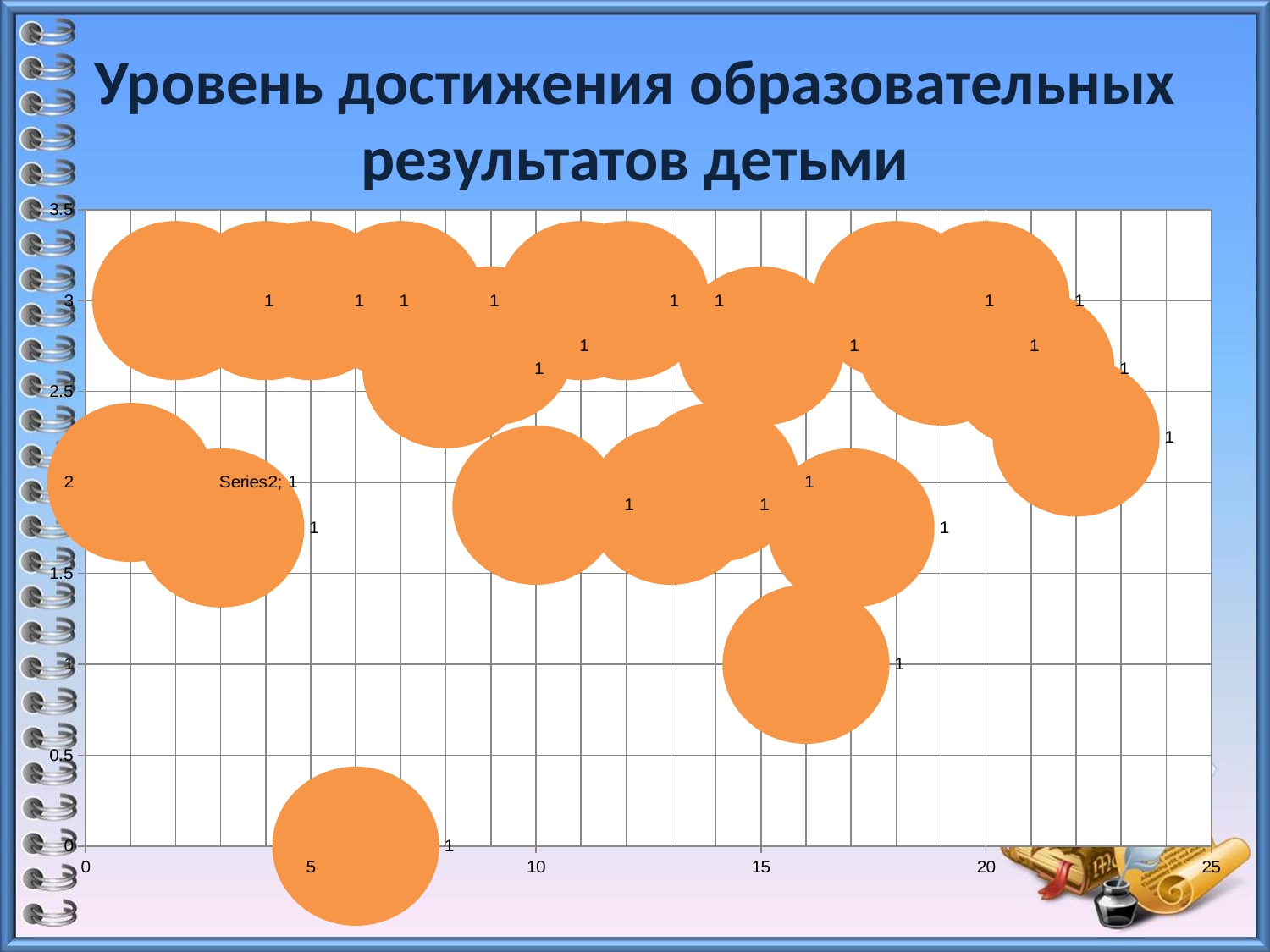
What is the title of the chart? Уровень достижения образовательных результатов детьми What value is printed on the data labels of the bubbles? 1 What kind of chart is shown on the slide? bubble chart Is the vertical-axis value of the bubble located near x = 16 at the lower middle of the chart greater or less than 1.5? less What colour are the bubbles in the chart? orange What series name appears in the data label near the left of the chart? Series2 Is the vertical-axis value of the bubbles in the top row greater or less than 2.5? greater Is the vertical-axis value of the lowest bubble (near x = 5–10) greater or less than 0.5? less